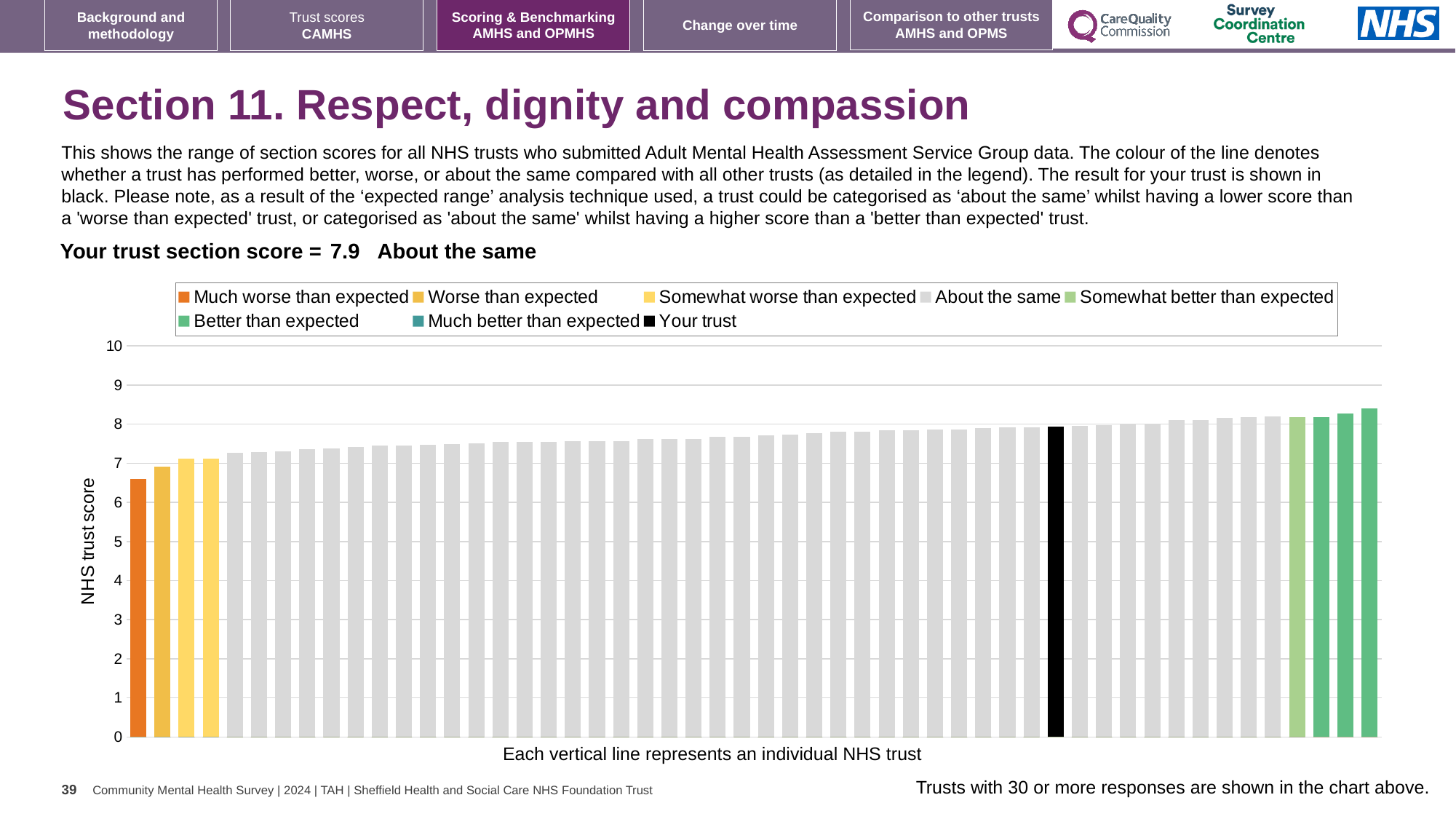
Which legend category does the lowest bar in the chart belong to? Much worse than expected What kind of chart is shown on the slide? bar chart Is the value of the leftmost (orange) bar greater or less than 7? less How is your trust's section score categorised compared with other trusts? About the same What is the label on the vertical axis of the chart? NHS trust score What colour is the bar representing your trust? black Is the value of the rightmost bar greater or less than 8? greater How many entries does the chart legend list? 8 Is the value of the black 'Your trust' bar greater or less than 7? greater Do the bar values rise or fall from left to right along the x axis? rise What is your trust's section score for Section 11, Respect, dignity and compassion? 7.9 Which legend category does the highest bar in the chart belong to? Better than expected